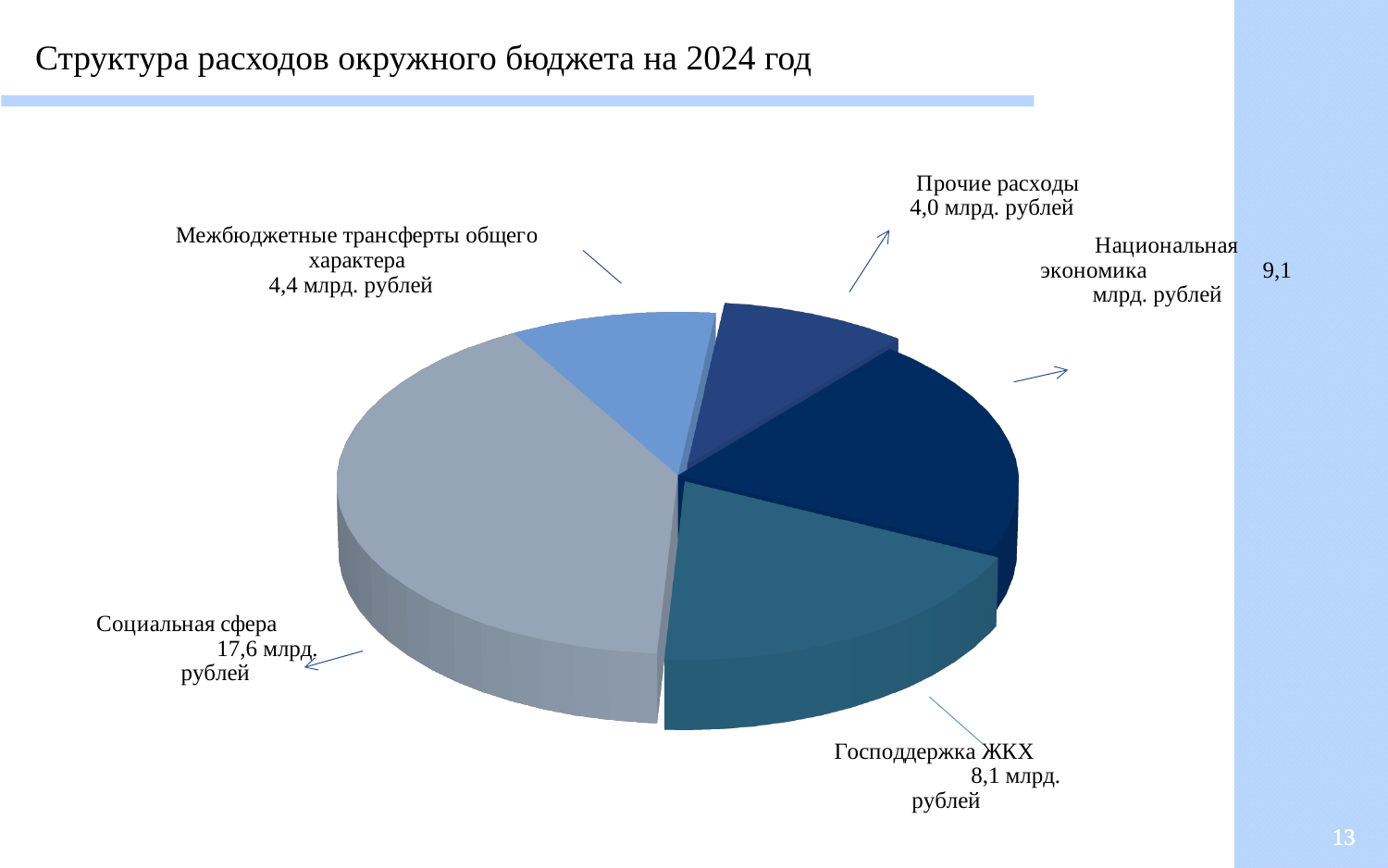
Which is larger: Национальная экономика or Господдержка ЖКХ? Национальная экономика What is the value for Прочие расходы in the pie chart? 4,0 млрд. рублей How many categories are shown in the pie chart? 5 What is the value for Социальная сфера in the pie chart? 17,6 млрд. рублей What is the difference between the values for Социальная сфера and Господдержка ЖКХ? 9,5 млрд. рублей What is the value for Межбюджетные трансферты общего характера in the pie chart? 4,4 млрд. рублей Which category has the largest slice in the pie chart? Социальная сфера What is the title of the slide? Структура расходов окружного бюджета на 2024 год What is the value for Национальная экономика in the pie chart? 9,1 млрд. рублей What kind of chart is shown on the slide? Pie chart What is the value for Господдержка ЖКХ in the pie chart? 8,1 млрд. рублей Which category has the smallest slice in the pie chart? Прочие расходы